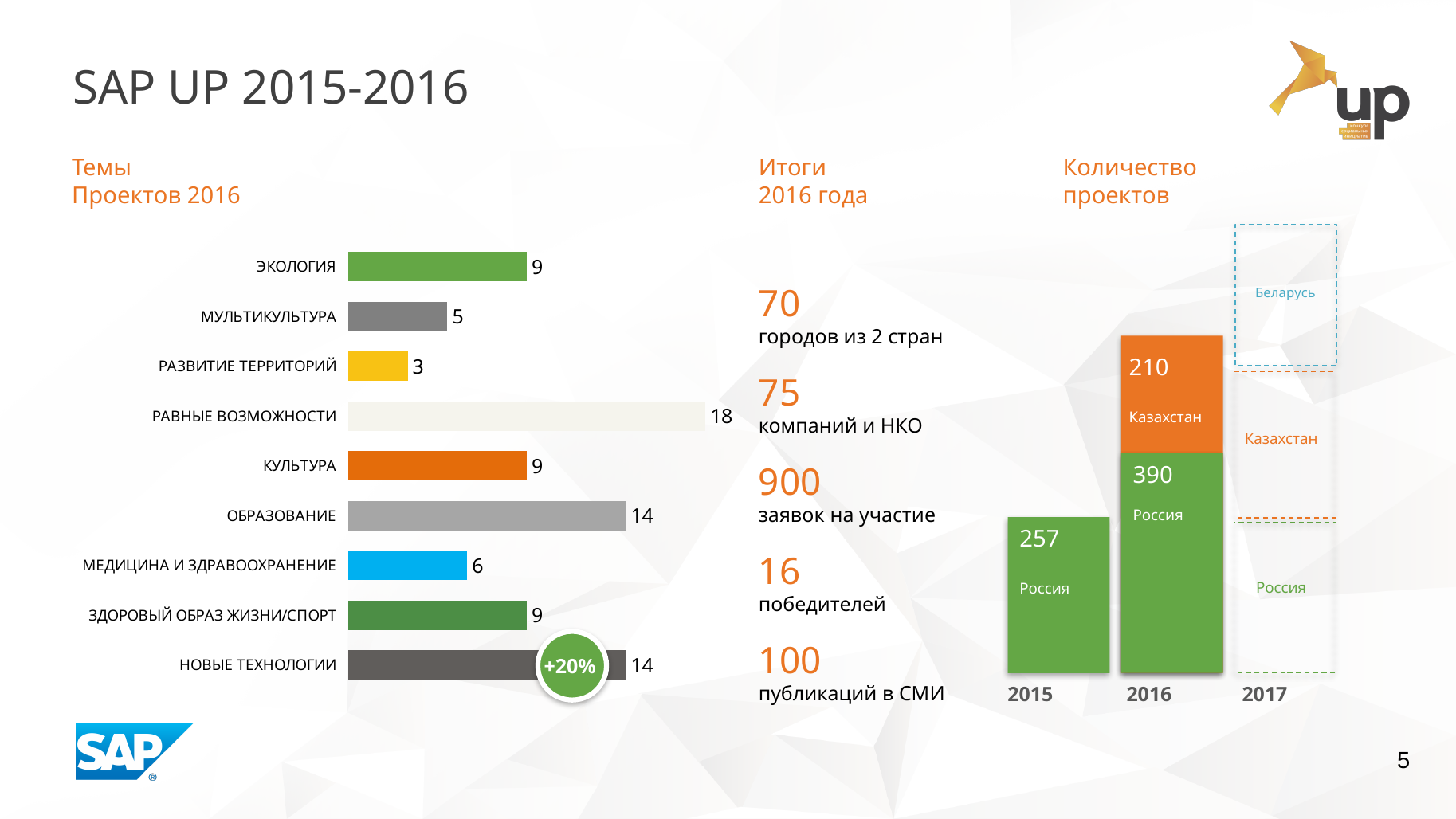
In the 'Темы Проектов 2016' chart, what is the value for МЕДИЦИНА И ЗДРАВООХРАНЕНИЕ? 6 In the 'Темы Проектов 2016' chart, what is the value for РАВНЫЕ ВОЗМОЖНОСТИ? 18 What type of chart is 'Темы Проектов 2016'? bar chart In the 'Количество проектов' chart, what is the value for Казахстан in 2016? 210 In the 'Количество проектов' chart, what is the difference between Россия in 2016 and Россия in 2015? 133 In the 'Темы Проектов 2016' chart, which category has the highest value? РАВНЫЕ ВОЗМОЖНОСТИ In the 'Количество проектов' chart, what is the total of the stacked bar for 2016? 600 In the 'Темы Проектов 2016' chart, which is larger: ЭКОЛОГИЯ or МЕДИЦИНА И ЗДРАВООХРАНЕНИЕ? ЭКОЛОГИЯ How many categories are shown in the 'Темы Проектов 2016' chart? 9 In the 'Темы Проектов 2016' chart, what is the difference between ОБРАЗОВАНИЕ and МУЛЬТИКУЛЬТУРА? 9 In the 'Количество проектов' chart, what is the value for Россия in 2015? 257 In the 'Темы Проектов 2016' chart, which category has the lowest value? РАЗВИТИЕ ТЕРРИТОРИЙ